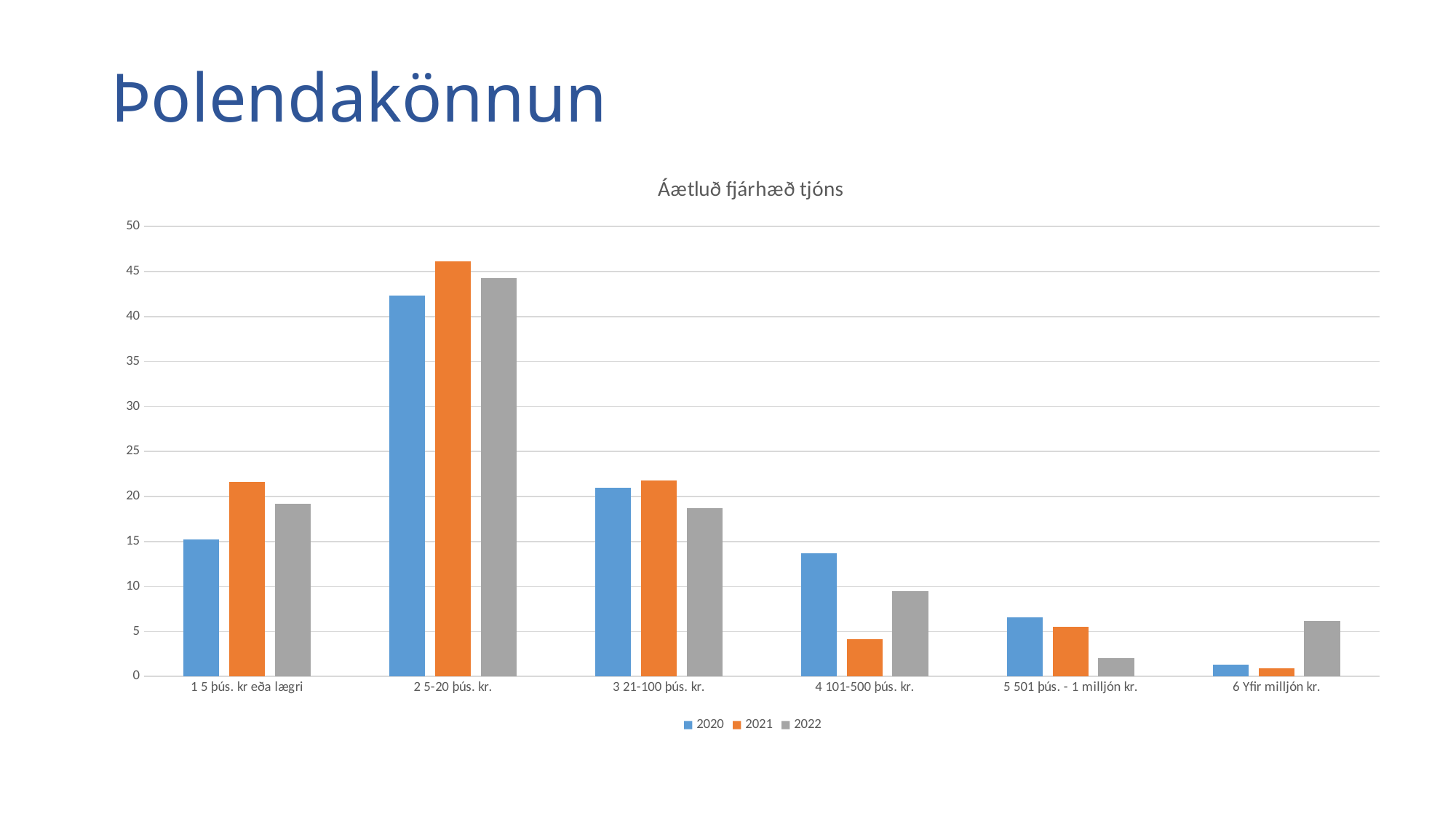
Is the 2021 value for 2 5-20 þús. kr. greater or less than 45? greater Which category has the lowest value for 2021? 6 Yfir milljón kr. How many series does the legend list? 3 For 4 101-500 þús. kr., which is larger: the 2020 value or the 2021 value? 2020 Which category has the highest value for 2021? 2 5-20 þús. kr. Is the 2022 value for 5 501 þús. - 1 milljón kr. greater or less than 5? less How many categories are shown on the x axis? 6 For 6 Yfir milljón kr., which is larger: the 2020 value or the 2022 value? 2022 Is the 2020 value for 2 5-20 þús. kr. greater or less than 40? greater What kind of chart is shown on the slide? bar chart What is the title of the chart? Áætluð fjárhæð tjóns